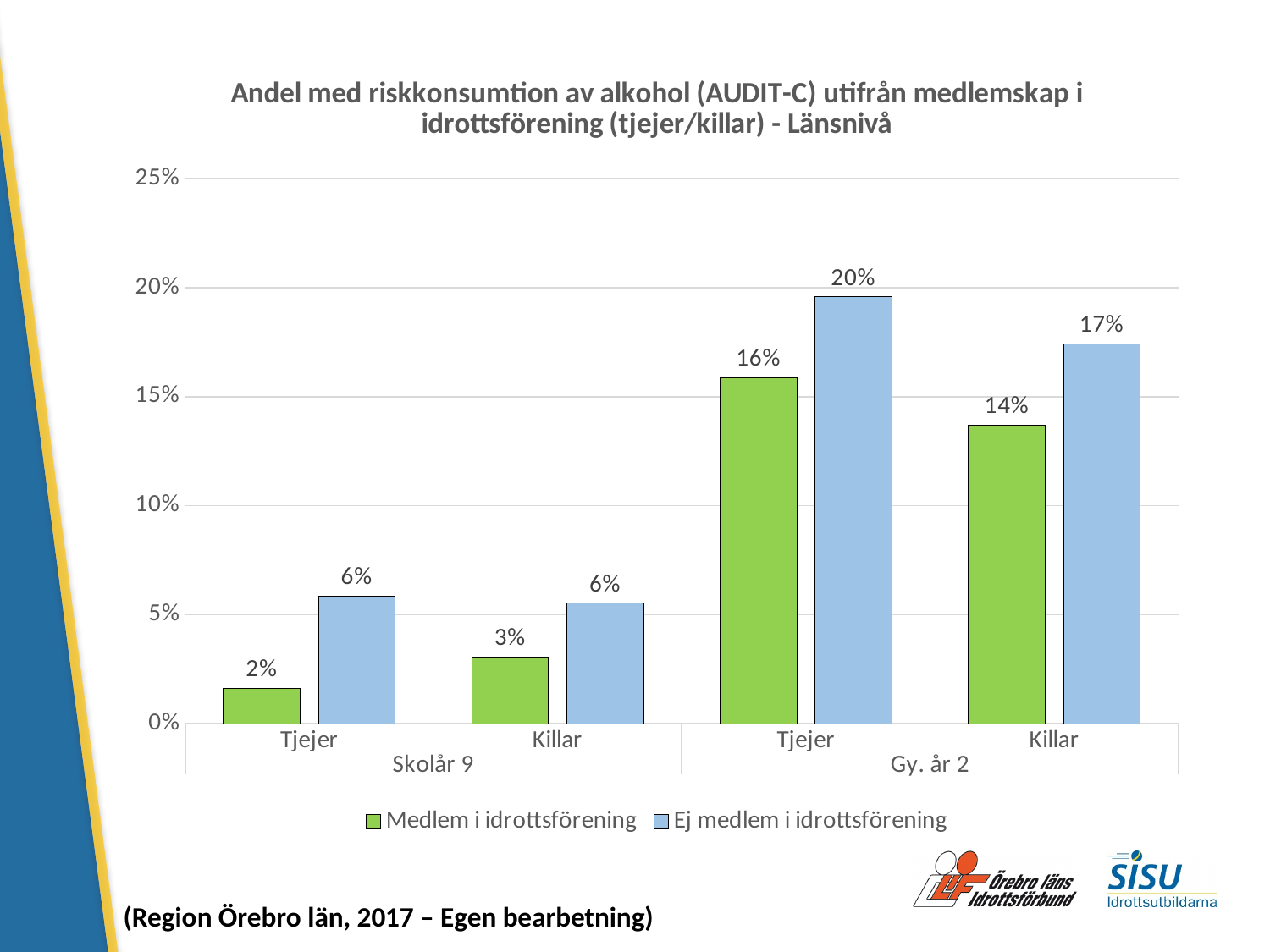
What is the value for Ej medlem i idrottsförening among Tjejer in Gy. år 2? 20% Which group has the lowest value in the chart? Medlem i idrottsförening, Tjejer, Skolår 9 What is the value for Medlem i idrottsförening among Killar in Gy. år 2? 14% Which colour represents Medlem i idrottsförening in the chart? Green Which is larger among Tjejer in Gy. år 2: Medlem i idrottsförening or Ej medlem i idrottsförening? Ej medlem i idrottsförening What is the difference between Ej medlem i idrottsförening and Medlem i idrottsförening among Killar in Gy. år 2? 3% What is the value for Medlem i idrottsförening among Tjejer in Skolår 9? 2% Is the value for Medlem i idrottsförening among Tjejer in Gy. år 2 greater or less than 15%? greater What is the value for Ej medlem i idrottsförening among Killar in Skolår 9? 6% Which group has the highest value in the chart? Ej medlem i idrottsförening, Tjejer, Gy. år 2 What kind of chart is shown on the slide? Bar chart How many series does the legend list? 2